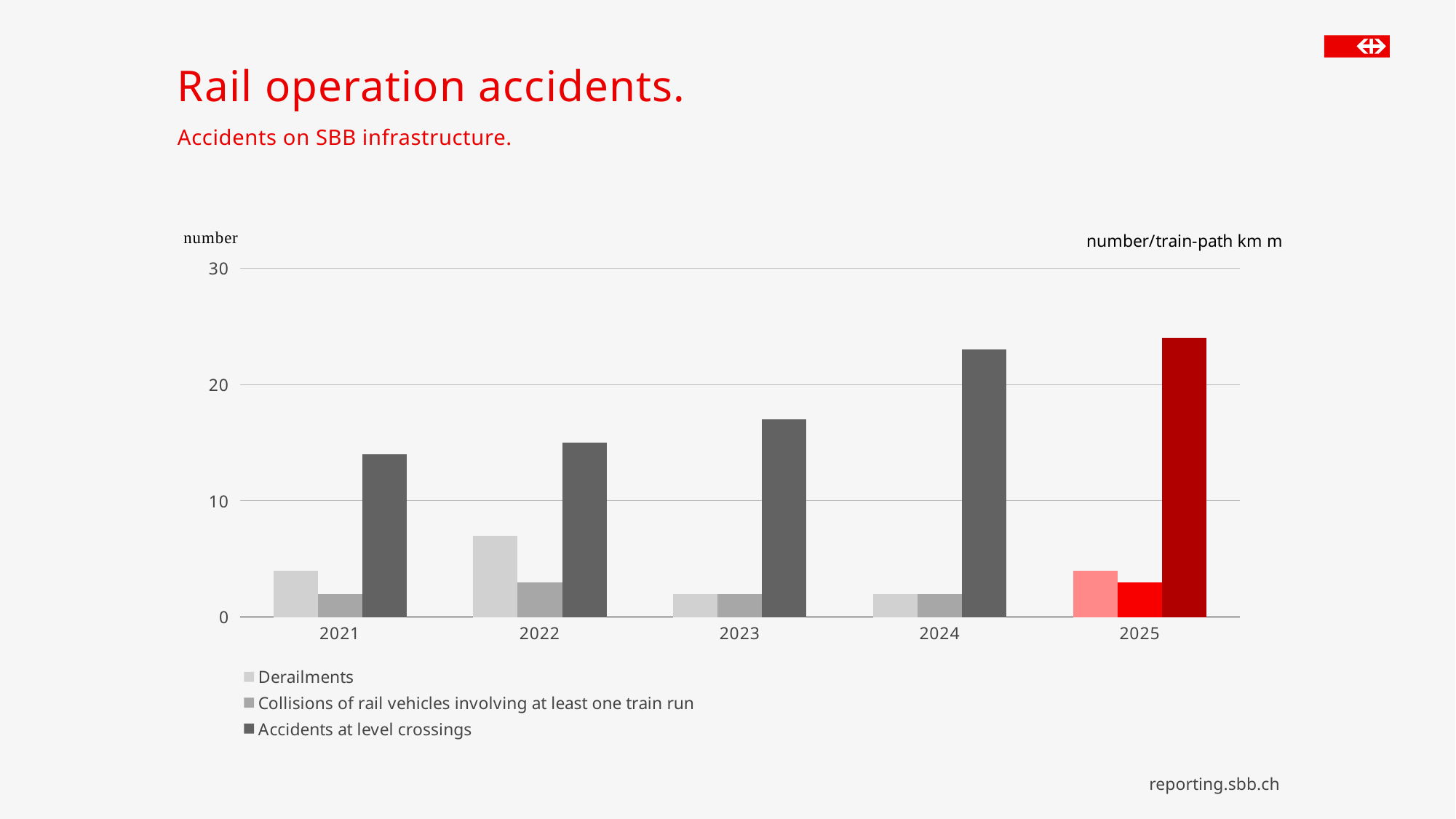
How many years are shown on the x axis? 5 Do the values for Accidents at level crossings rise or fall from 2021 to 2025? rise What kind of chart is shown on the slide? bar chart Which is larger: Derailments in 2022 or in 2023? 2022 Which is larger: Accidents at level crossings in 2024 or in 2021? 2024 Is the value for Accidents at level crossings in 2023 greater or less than 20? less How many series does the legend list? 3 What is the title of the chart slide? Rail operation accidents. Is the value for Derailments in 2022 greater or less than 10? less In which year is the value for Derailments highest? 2022 Is the value for Accidents at level crossings in 2024 greater or less than 20? greater